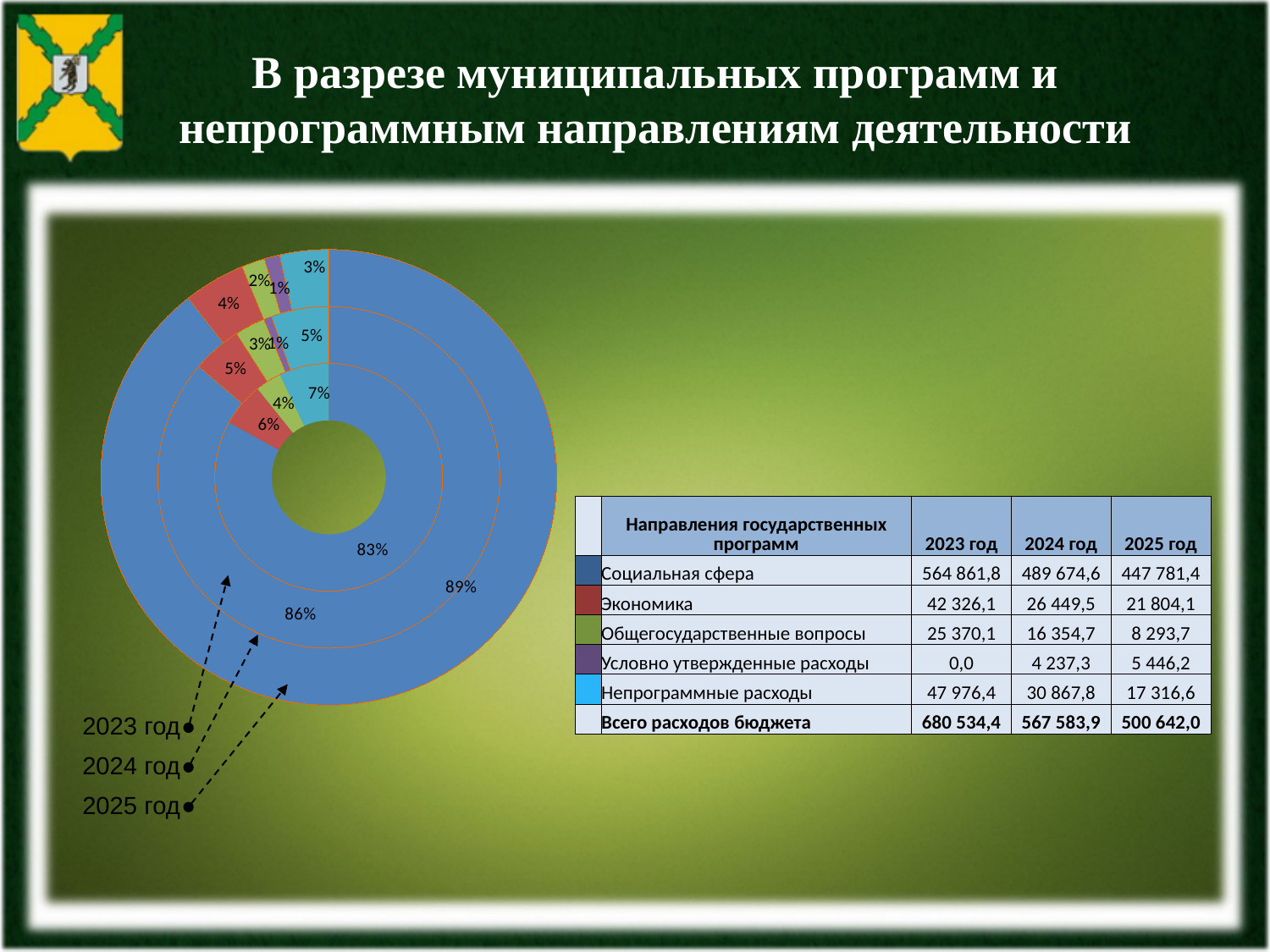
What share of the 2023 budget (inner ring) does Экономика take? 6% What share of the 2025 budget (outer ring) do Непрограммные расходы take? 3% What share of the 2024 budget (middle ring) does Социальная сфера take? 86% What kind of chart is shown on the slide? Doughnut (pie) chart Does the share of Социальная сфера rise or fall from 2023 to 2025? Rises How many rings (years) does the doughnut chart have? 3 Which category has the largest share in every ring of the chart? Социальная сфера Which year's data is shown in the innermost ring of the chart? 2023 год Which is larger in the 2024 ring: the share of Экономика or the share of Общегосударственные вопросы? Экономика